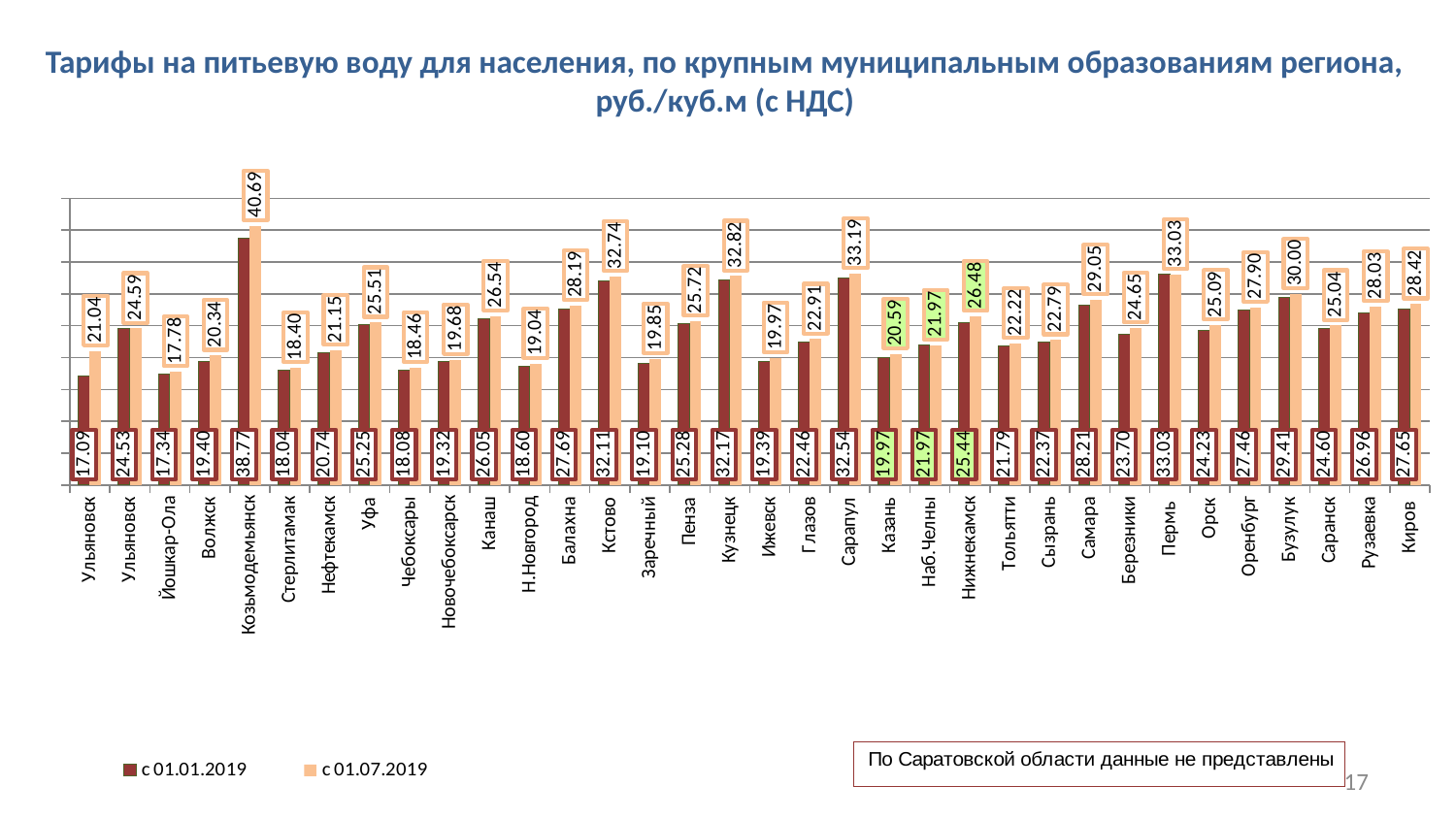
Which is larger in the 'с 01.07.2019' series: Пермь or Бузулук? Пермь What are the two series named in the legend? с 01.01.2019 and с 01.07.2019 Which municipality has the highest tariff in the 'с 01.07.2019' series? Козьмодемьянск What is the tariff for Козьмодемьянск in the 'с 01.07.2019' series? 40.69 What is the tariff for Самара in the 'с 01.01.2019' series? 28.21 What is the tariff for Казань in the 'с 01.07.2019' series? 20.59 What is the difference between the 'с 01.07.2019' and 'с 01.01.2019' values for Нижнекамск? 1.04 Which municipality has the lowest tariff in the 'с 01.07.2019' series? Йошкар-Ола What kind of chart is shown on the slide? bar chart How many municipalities (categories) are shown on the x axis? 34 How many series does the legend list? 2 What is the difference between the 'с 01.07.2019' and 'с 01.01.2019' values for Козьмодемьянск? 1.92